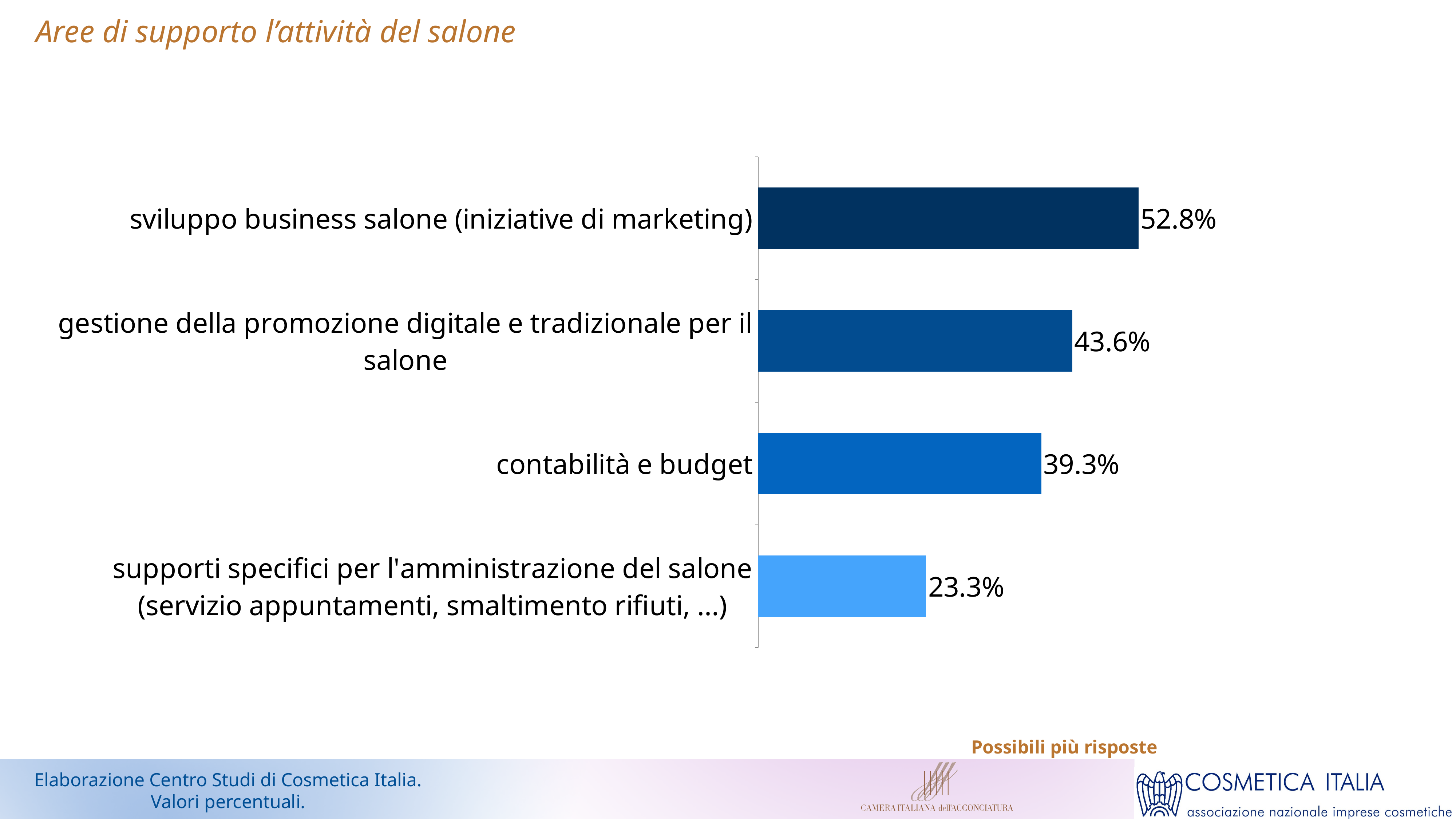
What is the difference between the values for 'gestione della promozione digitale e tradizionale per il salone' and 'supporti specifici per l'amministrazione del salone'? 20.3% What is the difference between the values for 'sviluppo business salone (iniziative di marketing)' and 'contabilità e budget'? 13.5% Which is larger: the value for 'gestione della promozione digitale e tradizionale per il salone' or for 'contabilità e budget'? gestione della promozione digitale e tradizionale per il salone What is the value for 'sviluppo business salone (iniziative di marketing)'? 52.8% What kind of chart is shown on the slide? bar chart How many categories are shown in the chart? 4 Which category has the lowest value? supporti specifici per l'amministrazione del salone (servizio appuntamenti, smaltimento rifiuti, ...) Which category has the highest value? sviluppo business salone (iniziative di marketing) What is the value for 'contabilità e budget'? 39.3% What is the value for 'supporti specifici per l'amministrazione del salone (servizio appuntamenti, smaltimento rifiuti, ...)'? 23.3% What is the title of the slide? Aree di supporto l'attività del salone What is the value for 'gestione della promozione digitale e tradizionale per il salone'? 43.6%